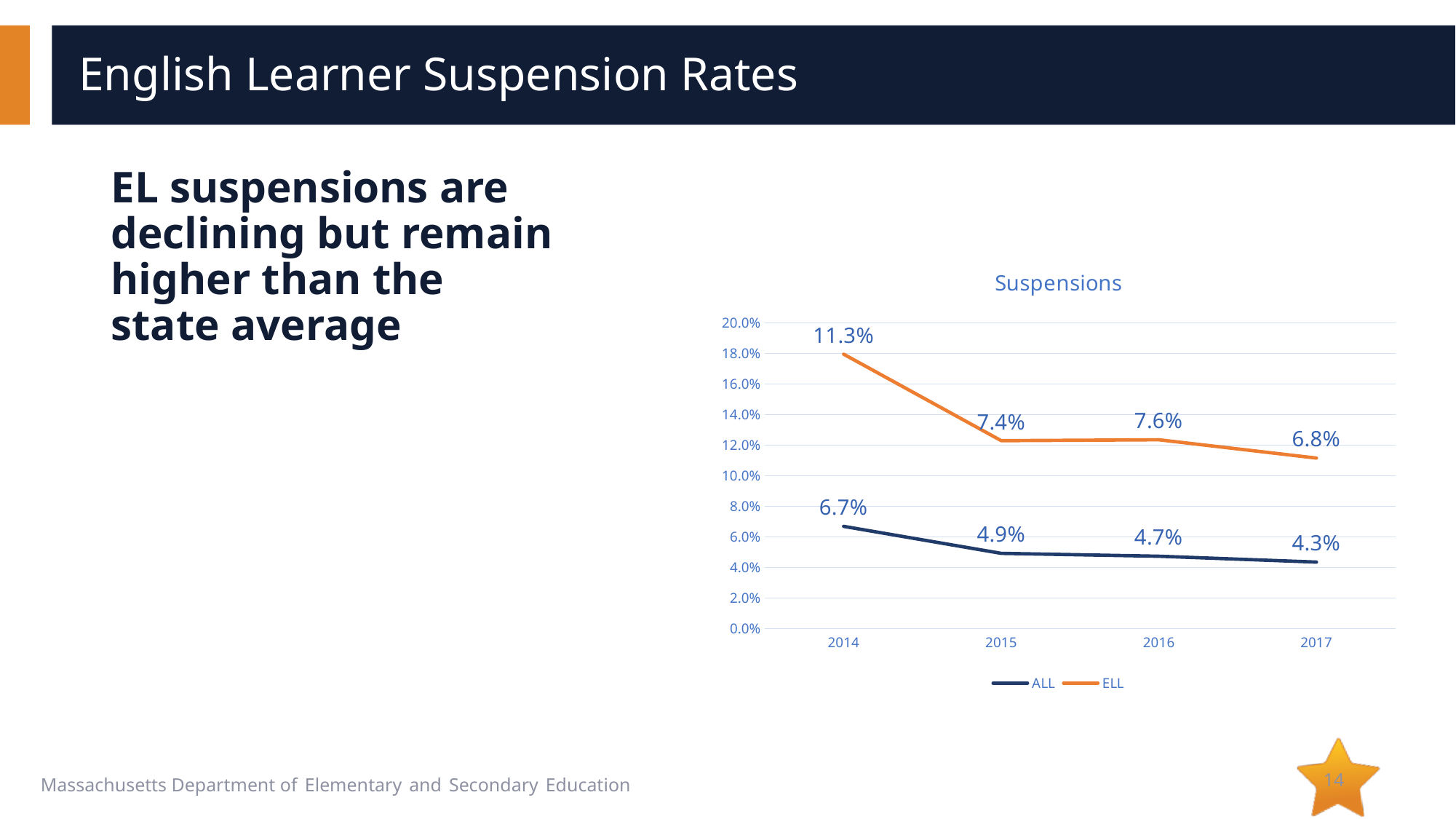
What is the difference between the ELL and ALL suspension rates in 2015? 2.5% What is the ALL suspension rate in 2017? 4.3% In which year is the ALL suspension rate lowest? 2017 What type of chart is shown on the slide? Line chart What is the ELL suspension rate in 2016? 7.6% What is the ELL suspension rate in 2014? 11.3% What is the title of the chart? Suspensions In which year is the ELL suspension rate highest? 2014 How many years are shown on the x axis of the chart? 4 Does the ALL suspension rate rise or fall from 2014 to 2017? Fall Which series has the higher suspension rate in 2017, ALL or ELL? ELL How many series does the legend list? 2